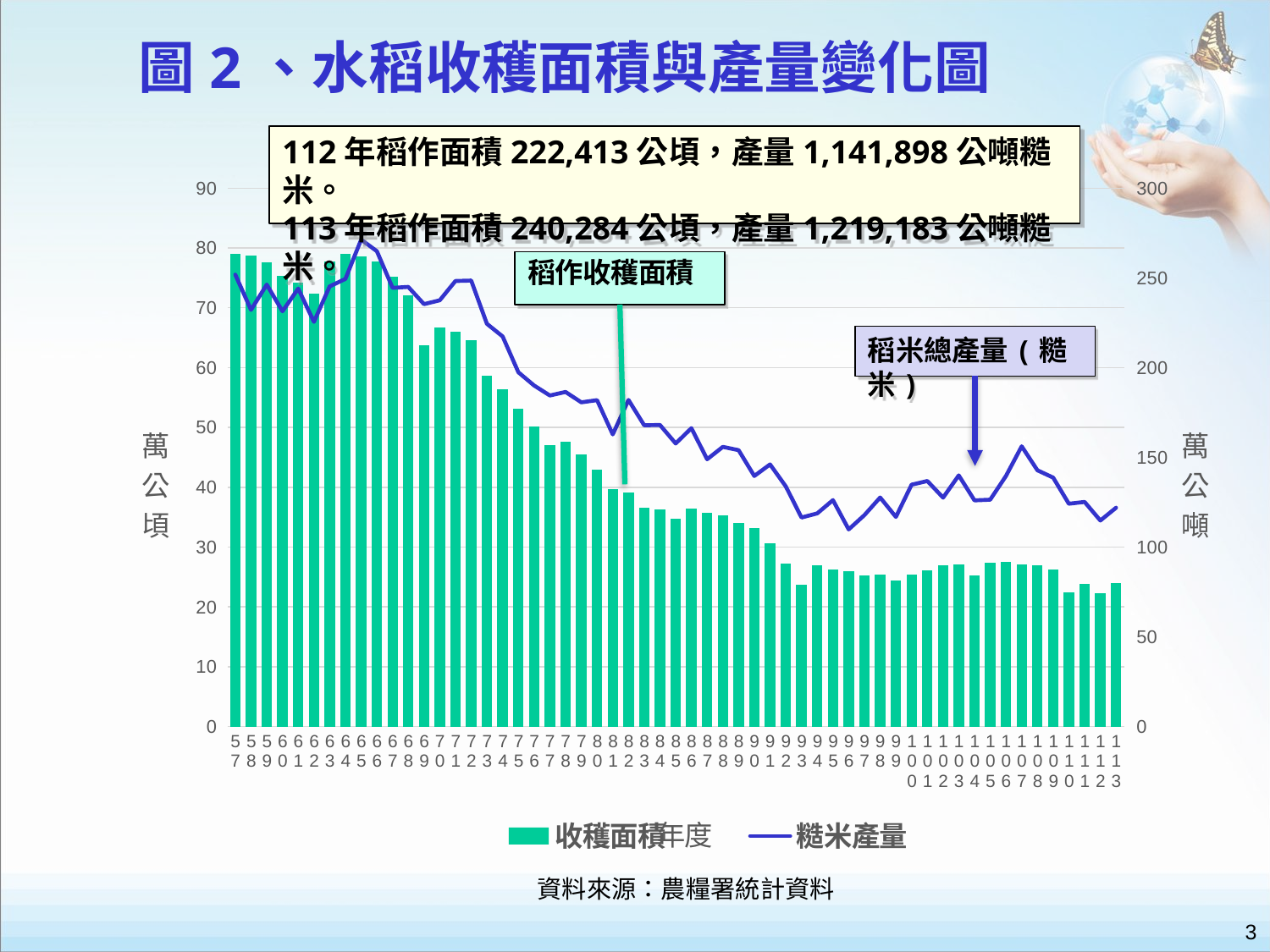
Do the 收穫面積 bars generally rise or fall from year 57 to year 113? Fall Which year had the larger brown rice production according to the text box, 112 or 113? 113 Is the 收穫面積 bar for year 57 greater or less than 70 on the left axis? greater What kind of chart is shown on the slide? A combined bar and line chart By how much did the rice planting area in year 113 exceed that of year 112, according to the text box? 17,871 公頃 Is the 收穫面積 bar for year 113 greater or less than 30 on the left axis? less According to the text box, what was the brown rice production in year 113? 1,219,183 公噸 How many series does the legend list? 2 Is the 糙米產量 line value for year 113 greater or less than 150 on the right axis? less What are the two series named in the legend? 收穫面積 and 糙米產量 According to the text box, what was the rice planting area in year 112? 222,413 公頃 What is the unit label on the left vertical axis? 萬公頃